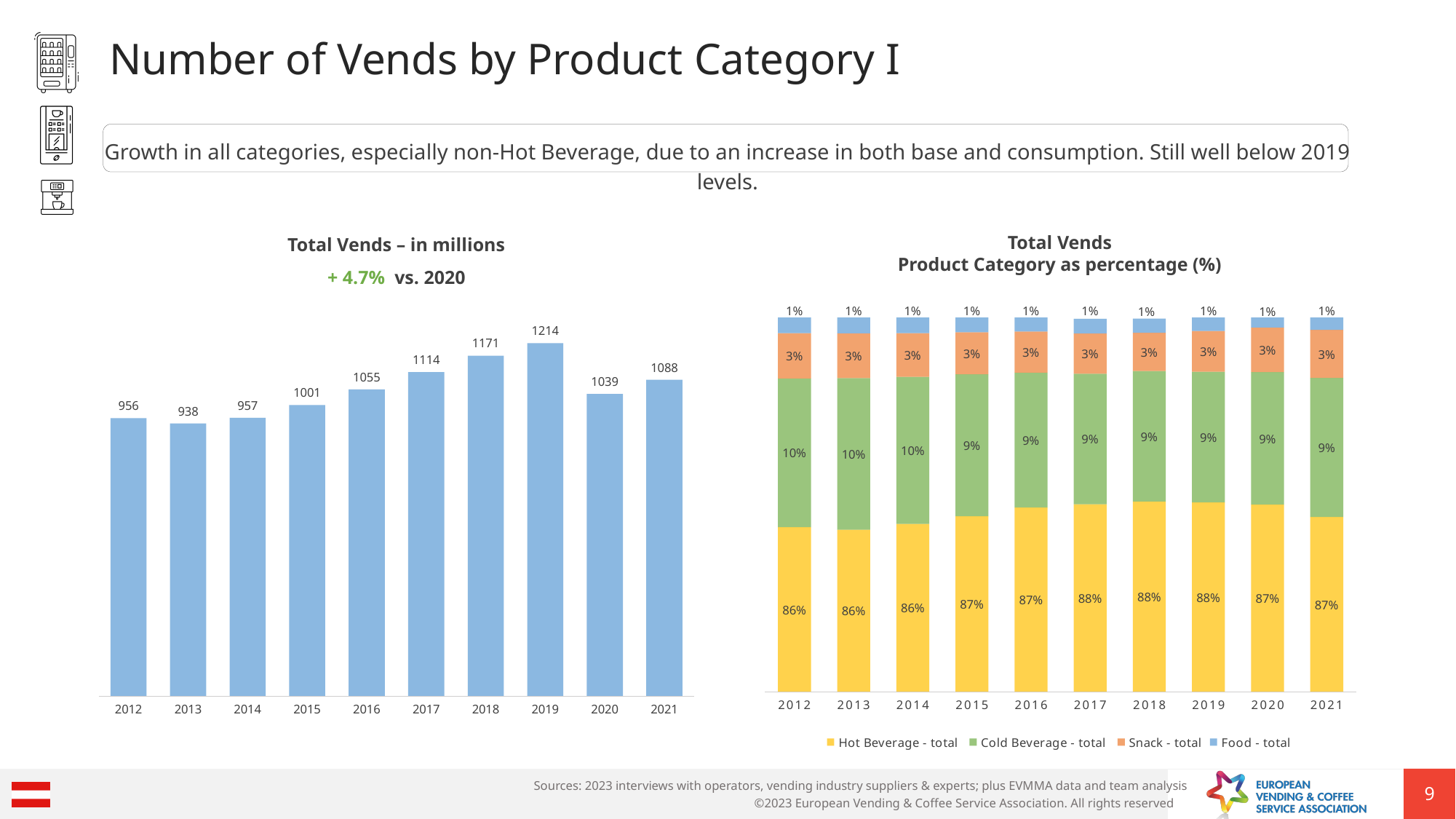
In the 'Total Vends – in millions' chart, which is larger, the value for 2020 or the value for 2021? 2021 In the 'Total Vends Product Category as percentage (%)' chart, what is the Hot Beverage - total share for 2018? 88% What kind of chart is the 'Total Vends – in millions' chart? Bar chart In the 'Total Vends – in millions' chart, which year has the highest value? 2019 How many series does the legend of the 'Total Vends Product Category as percentage (%)' chart list? 4 How many years are shown in the 'Total Vends – in millions' chart? 10 In the 'Total Vends – in millions' chart, what is the difference between the 2019 and 2021 values? 126 In the 'Total Vends Product Category as percentage (%)' chart, which colour represents Snack - total? Orange In the 'Total Vends Product Category as percentage (%)' chart, what is the Cold Beverage - total share for 2012? 10% In the 'Total Vends – in millions' chart, what is the value for 2021? 1088 In the 'Total Vends – in millions' chart, which year has the lowest value? 2013 In the 'Total Vends – in millions' chart, what is the value for 2019? 1214